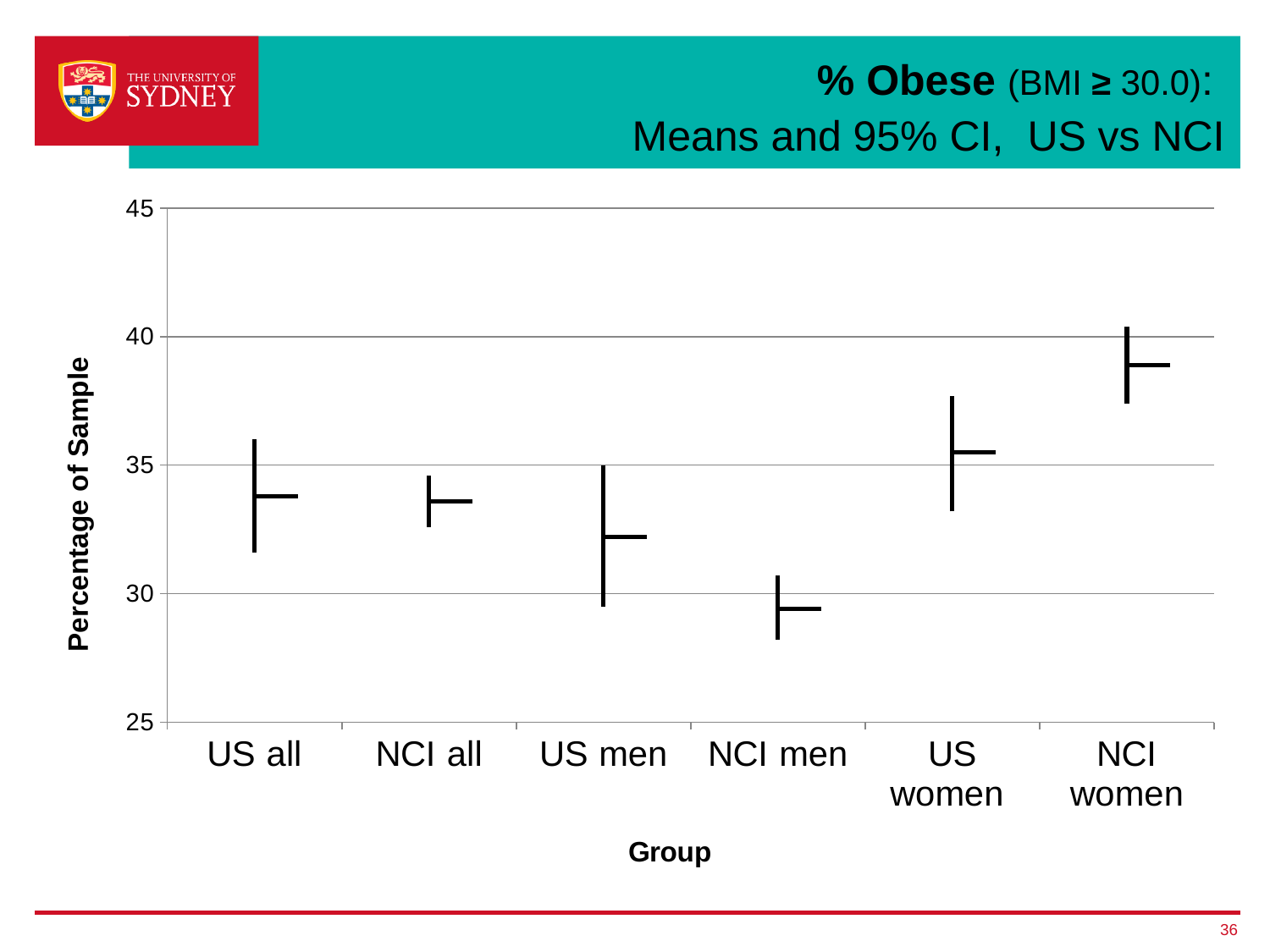
Is the mean value for US men greater or less than 35? less How many groups are shown on the x axis? 6 What is the label of the x axis? Group Which has a higher mean percentage obese, US men or NCI men? US men Is the mean value for US all greater or less than 30? greater What is the label of the y axis? Percentage of Sample Which group has the highest mean percentage obese? NCI women Which group has the lowest mean percentage obese? NCI men Which has a higher mean percentage obese, US women or US men? US women Is the mean value for NCI men greater or less than 30? less Which has a higher mean percentage obese, NCI women or US women? NCI women